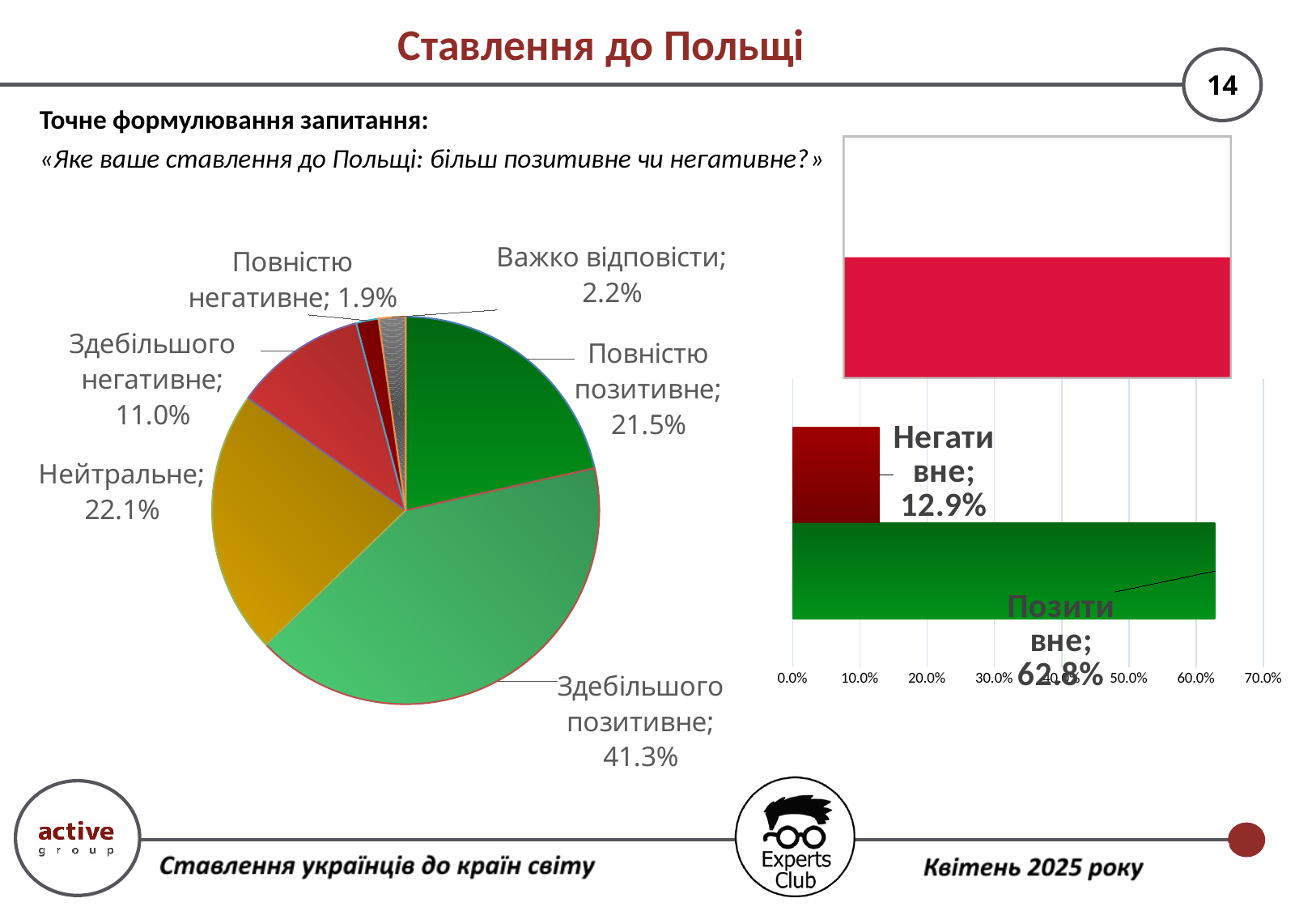
In the bar chart on the right, what is the value for "Негативне"? 12.9% In the pie chart on the left, how many slices are there? 6 In the pie chart on the left, which category has the largest slice? Здебільшого позитивне What type of chart is shown on the right side of the slide? Bar chart In the pie chart on the left, which category has the smallest slice? Повністю негативне In the pie chart on the left, what share is labelled "Здебільшого позитивне"? 41.3% In the bar chart on the right, what is the difference between "Позитивне" and "Негативне"? 49.9% In the pie chart on the left, what share is labelled "Повністю негативне"? 1.9% In the pie chart on the left, what is the difference between "Нейтральне" and "Повністю позитивне"? 0.6% In the pie chart on the left, which is larger: "Здебільшого негативне" or "Важко відповісти"? Здебільшого негативне In the bar chart on the right, what is the value for "Позитивне"? 62.8% In the pie chart on the left, what share is labelled "Нейтральне"? 22.1%